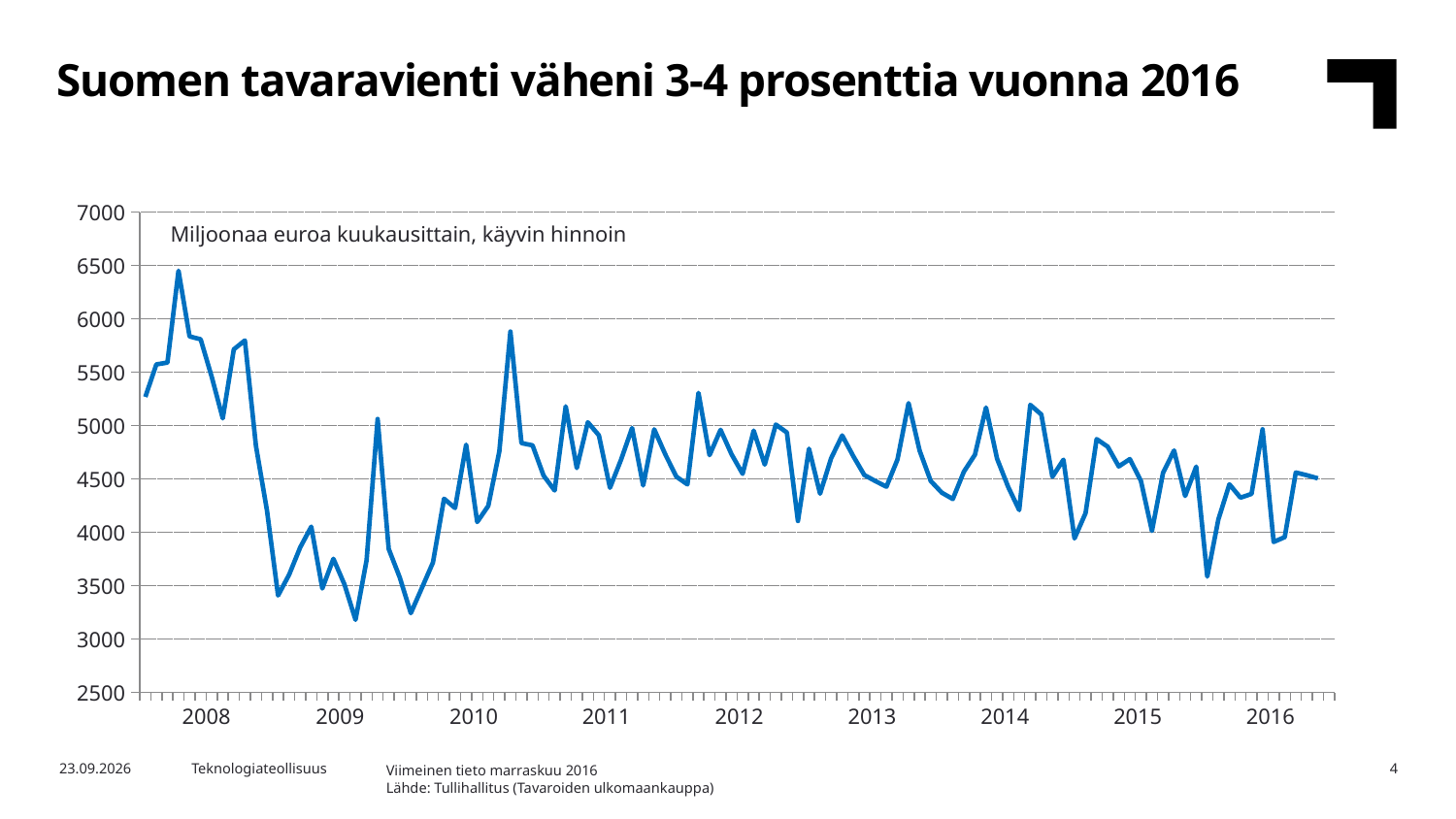
Overall, is the level of the line at the end of 2016 higher or lower than at the start of 2008? lower Is the lowest point of the line in 2009 greater or less than 3500? less What is the title of the slide containing the chart? Suomen tavaravienti väheni 3-4 prosenttia vuonna 2016 Is the highest peak of the line in 2008 greater or less than 6000? greater What is the first year labelled on the x axis? 2008 What is the last year labelled on the x axis? 2016 Is the last plotted value in 2016 greater or less than 5000? less What unit description is printed inside the chart area? Miljoonaa euroa kuukausittain, käyvin hinnoin In which year does the line reach its lowest point? 2009 How many year labels are shown on the x axis? 9 In which year does the line reach its highest peak? 2008 What kind of chart is shown on the slide? Line chart